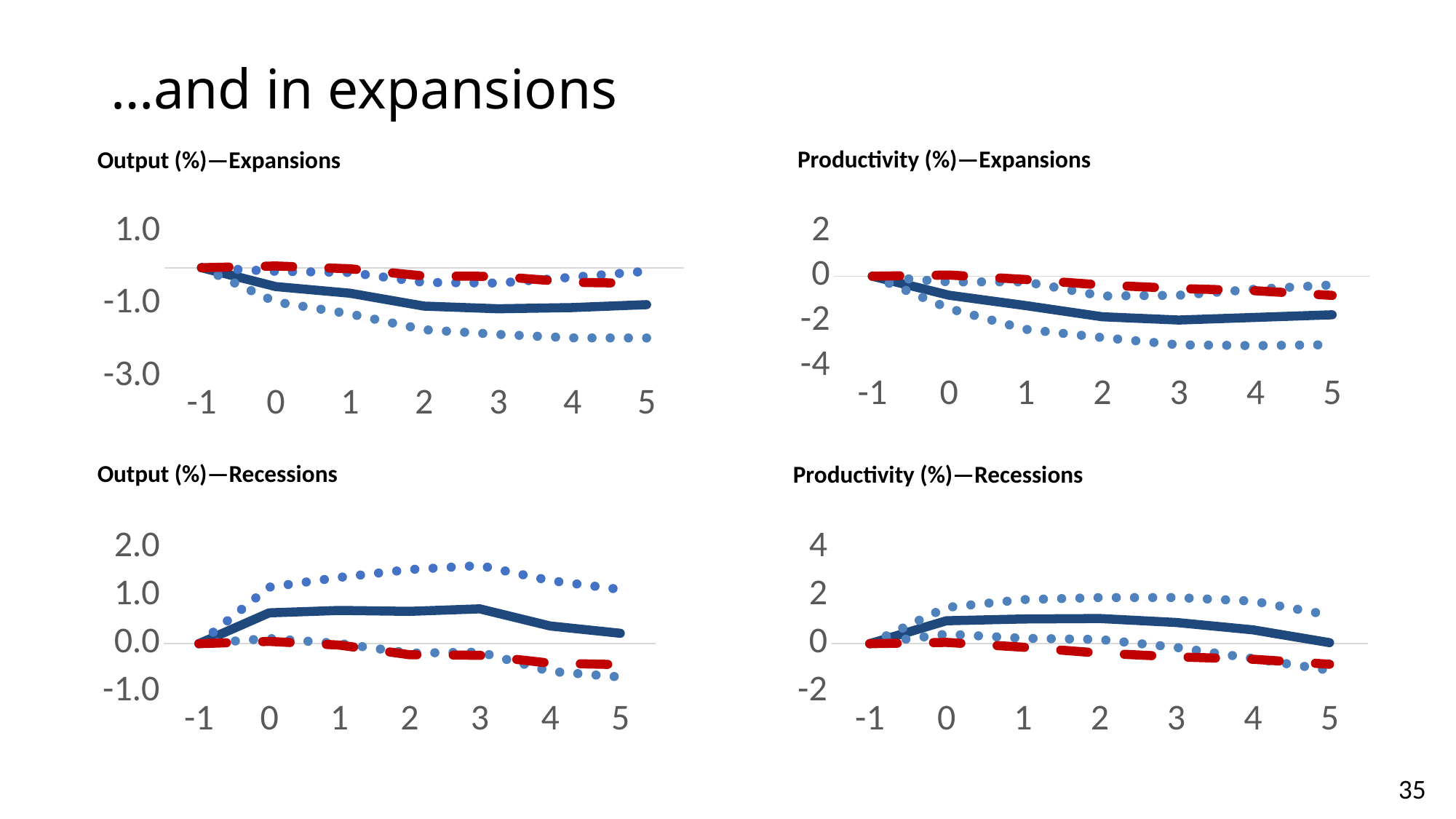
In the Productivity (%)—Recessions chart, does the solid line rise or fall from x = -1 to x = 0? rise In the Output (%)—Expansions chart, is the value of the solid line at x = 0 greater or less than -1.0? greater In the Productivity (%)—Recessions chart, is the value of the red dashed line at x = 5 greater or less than 0? less In the Productivity (%)—Expansions chart, is the value of the lower dotted line at x = 5 greater or less than -2? less In the Productivity (%)—Expansions chart, does the solid line rise or fall from x = -1 to x = 3? fall In the Output (%)—Recessions chart, does the solid line rise or fall from x = 3 to x = 5? fall How many points are labelled on the x axis of the Productivity (%)—Recessions chart? 7 What is the title of the chart in the bottom-right position of the slide? Productivity (%)—Recessions What kind of chart is the Output (%)—Expansions chart? line chart